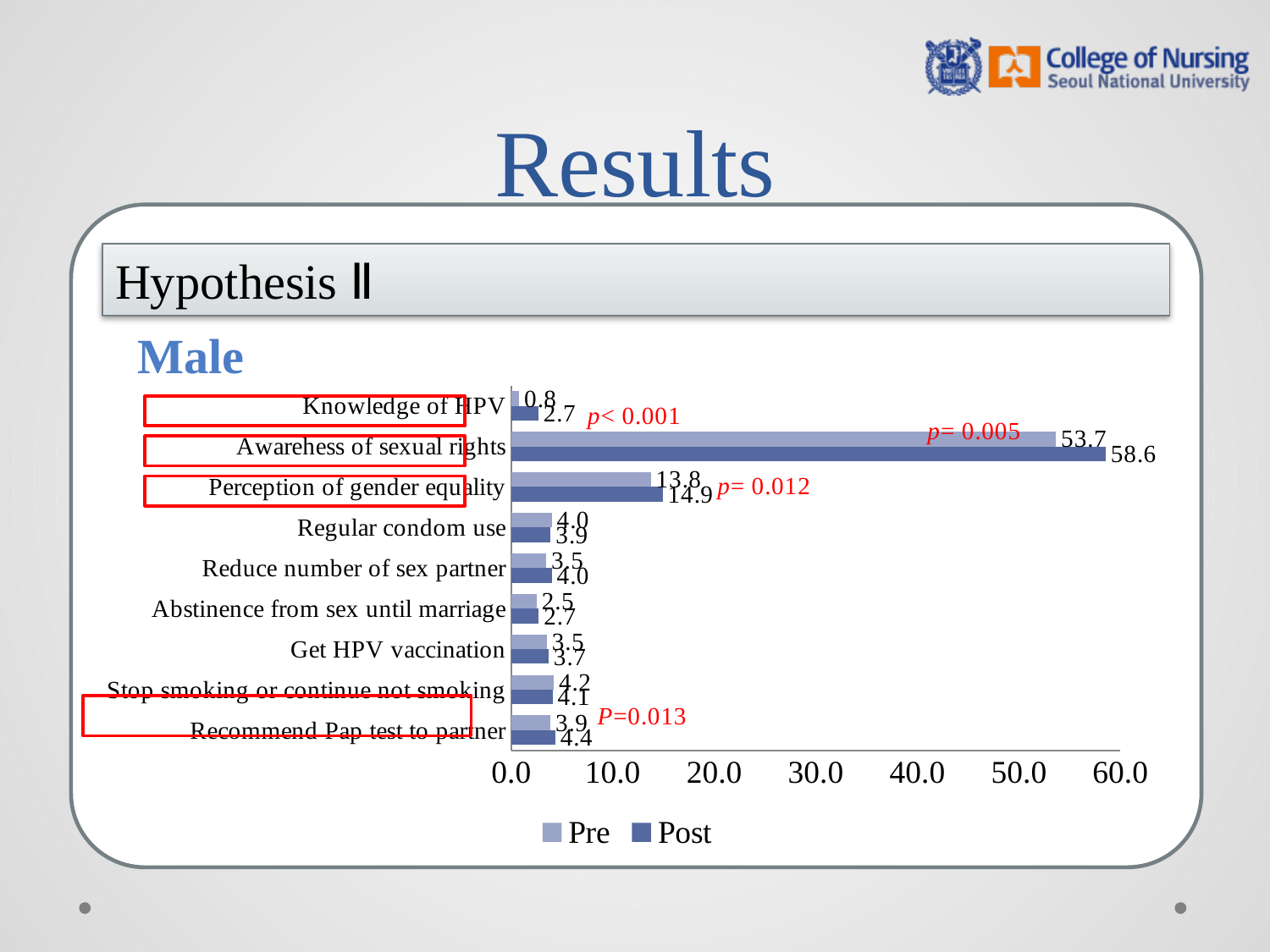
What kind of chart is shown on the slide? Bar chart Which category has the highest Post value? Awareness of sexual rights Is the Pre value for Awareness of sexual rights greater or less than 50.0? greater How many categories are shown on the chart? 9 Which category has the lowest Pre value? Knowledge of HPV How many series does the legend list? 2 What is the Pre value for Knowledge of HPV? 0.8 What is the Post value for Recommend Pap test to partner? 4.4 What is the Post value for Awareness of sexual rights? 58.6 What is the difference between the Post and Pre values for Awareness of sexual rights? 4.9 What is the Pre value for Perception of gender equality? 13.8 Which is larger for Perception of gender equality, the Pre value or the Post value? Post